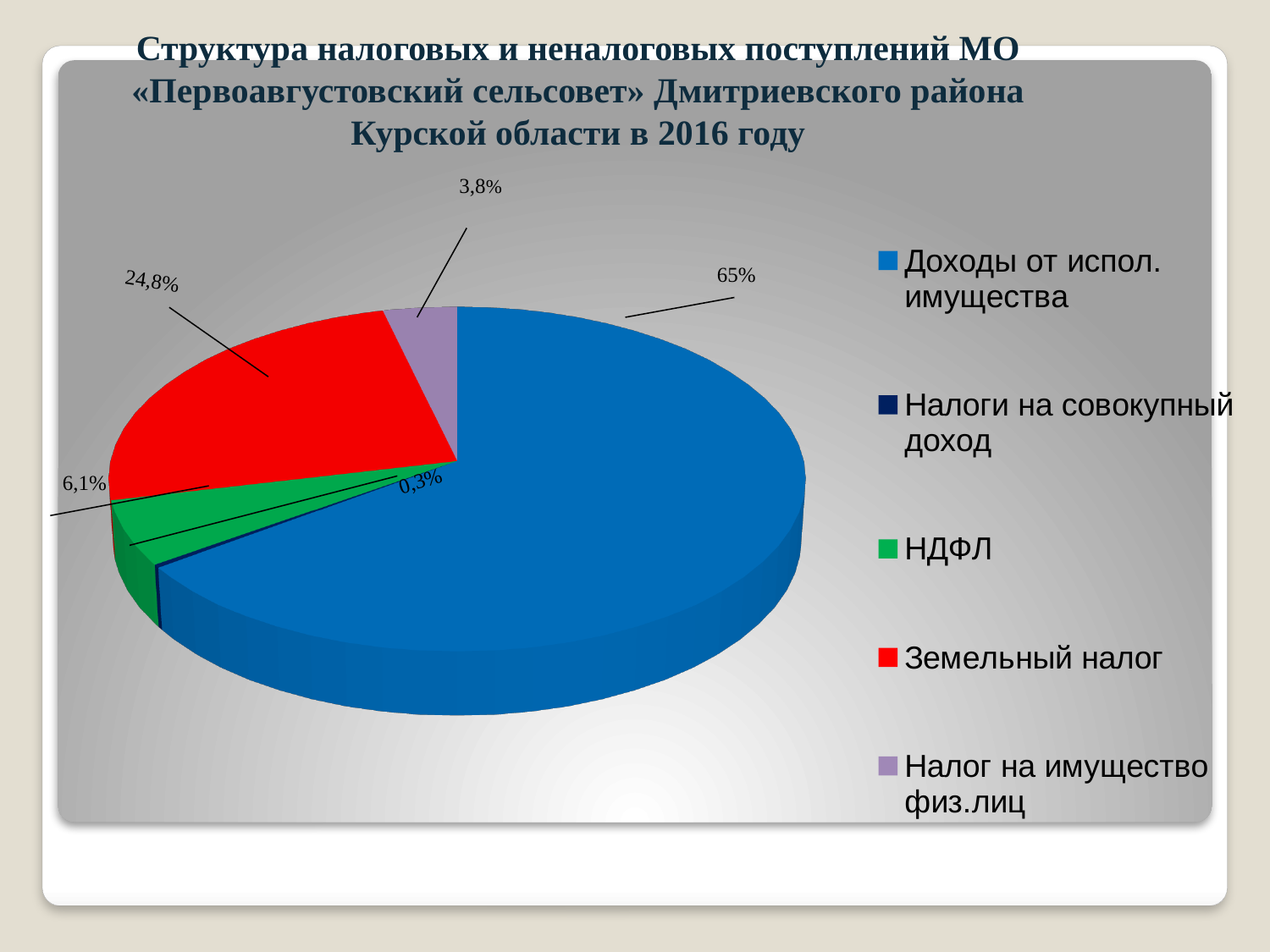
What share of the pie does «НДФЛ» have? 6,1% What kind of chart is shown on the slide? pie chart What share of the pie does «Налог на имущество физ.лиц» have? 3,8% What is the difference in percentage points between «Доходы от испол. имущества» and «Земельный налог»? 40,2 What share of the pie does «Налоги на совокупный доход» have? 0,3% What colour is the slice for «Земельный налог»? red Which is larger: the share for «НДФЛ» or the share for «Налог на имущество физ.лиц»? НДФЛ What share of the pie does «Доходы от испол. имущества» have? 65% Which category has the smallest share of the pie? Налоги на совокупный доход What share of the pie does «Земельный налог» have? 24,8% How many categories does the legend list? 5 Which category has the largest share of the pie? Доходы от испол. имущества